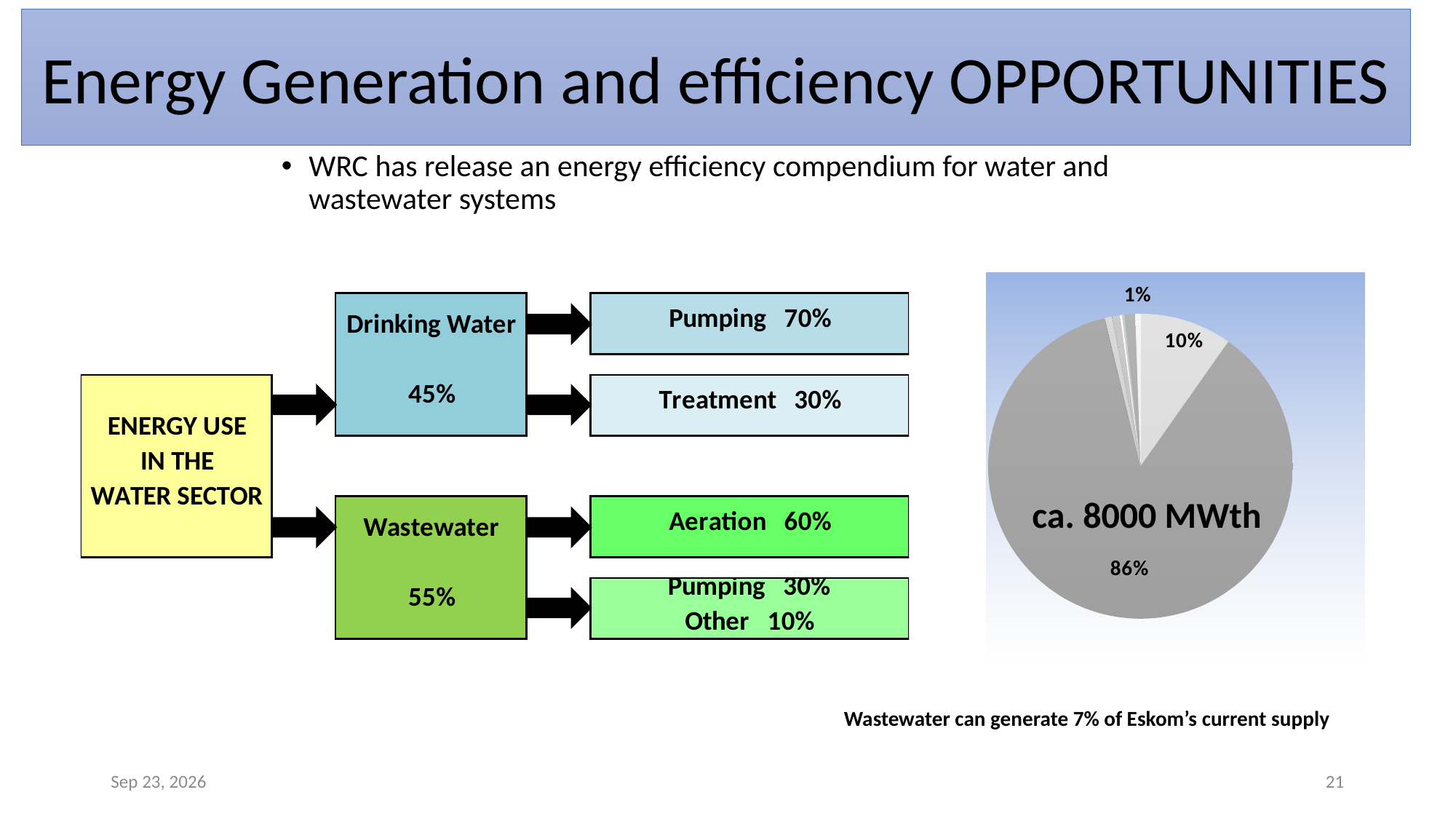
In the pie chart, what is the value of the second-largest slice? 10% Does the pie chart have a legend? No In the pie chart, what is the smallest value printed as a data label? 1% How many percentage data labels are printed on the pie chart? 3 What text is printed inside the pie chart's largest slice besides its percentage? ca. 8000 MWth In the pie chart, which slice is larger: the one labelled 86% or the one labelled 10%? the 86% slice What kind of chart is shown on the right side of the slide? pie chart In the pie chart, what is the value of the largest slice? 86% In the pie chart, what is the difference between the largest slice (86%) and the 10% slice? 76 percentage points